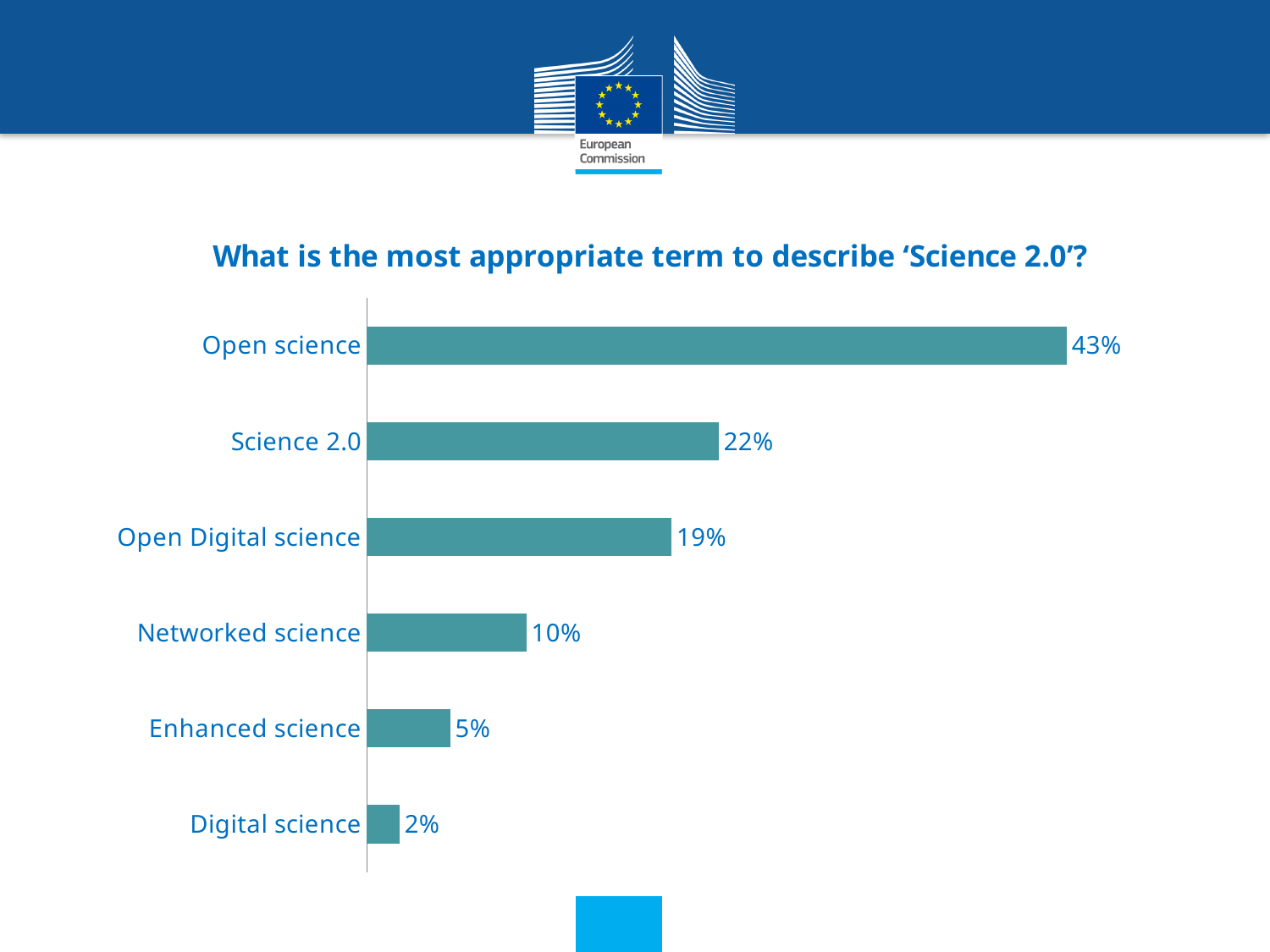
Which term received the lowest percentage? Digital science What is the value shown for 'Science 2.0'? 22% What is the difference in percentage points between 'Open science' and 'Science 2.0'? 21 What is the title of the chart? What is the most appropriate term to describe 'Science 2.0'? What percentage is shown for 'Networked science'? 10% Which has a larger value, 'Science 2.0' or 'Open Digital science'? Science 2.0 Which term received the highest percentage? Open science What percentage of respondents chose 'Open science' as the most appropriate term? 43% What type of chart is shown on the slide? Bar chart What is the value for 'Enhanced science'? 5% How many terms are listed in the chart? 6 What is the difference between 'Open Digital science' and 'Digital science'? 17%